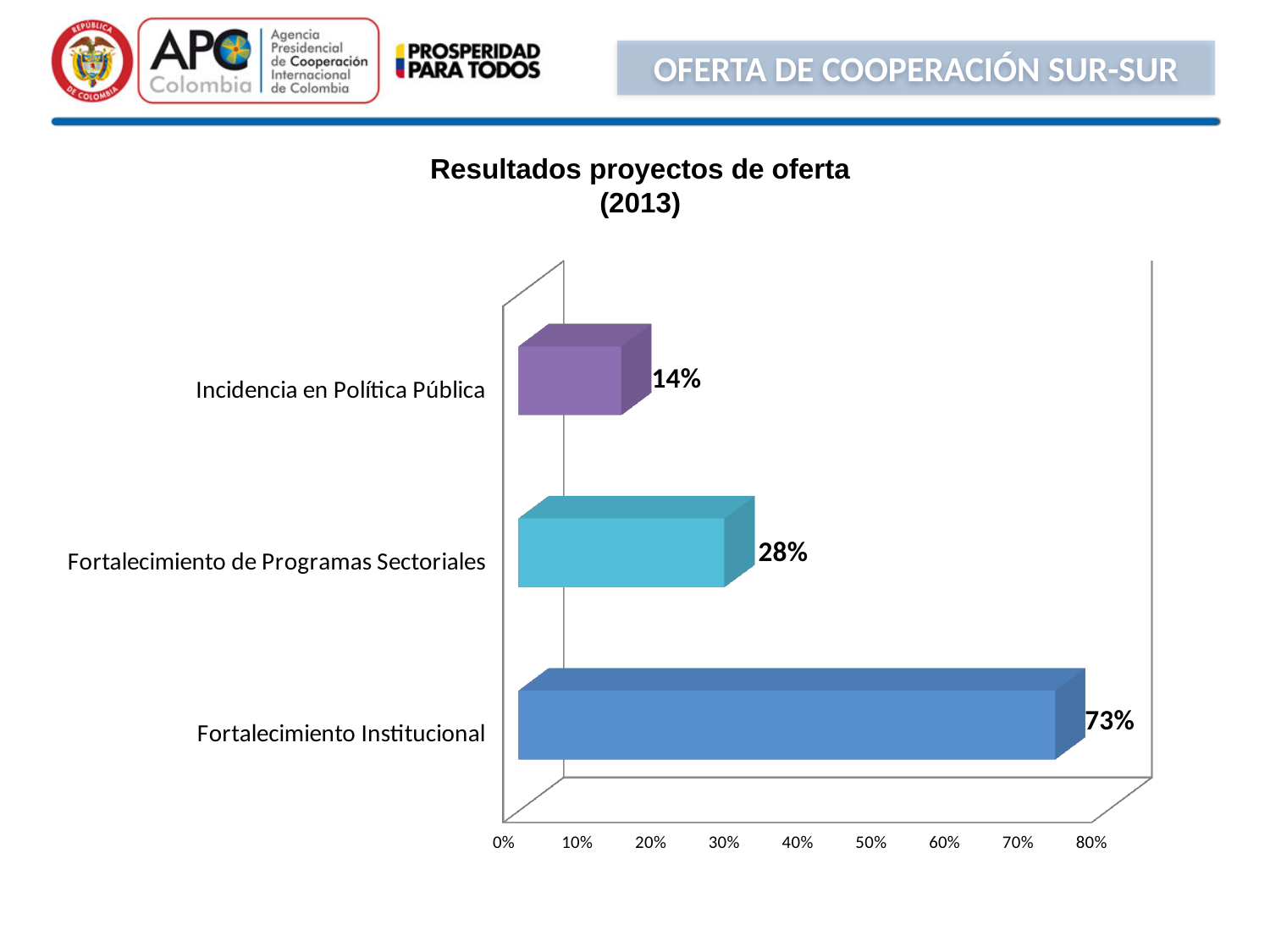
What is the difference between the values for Fortalecimiento Institucional and Fortalecimiento de Programas Sectoriales? 45% Is the value for Fortalecimiento Institucional greater or less than 50%? greater Which is larger, the value for Fortalecimiento de Programas Sectoriales or the value for Incidencia en Política Pública? Fortalecimiento de Programas Sectoriales How many categories are shown in the chart? 3 Which category has the highest value? Fortalecimiento Institucional What kind of chart is shown on the slide? Bar chart Which category has the lowest value? Incidencia en Política Pública What is the value for Incidencia en Política Pública? 14% What is the difference between the values for Fortalecimiento de Programas Sectoriales and Incidencia en Política Pública? 14% What is the title of the chart? Resultados proyectos de oferta (2013) What is the value for Fortalecimiento Institucional? 73% What is the value for Fortalecimiento de Programas Sectoriales? 28%